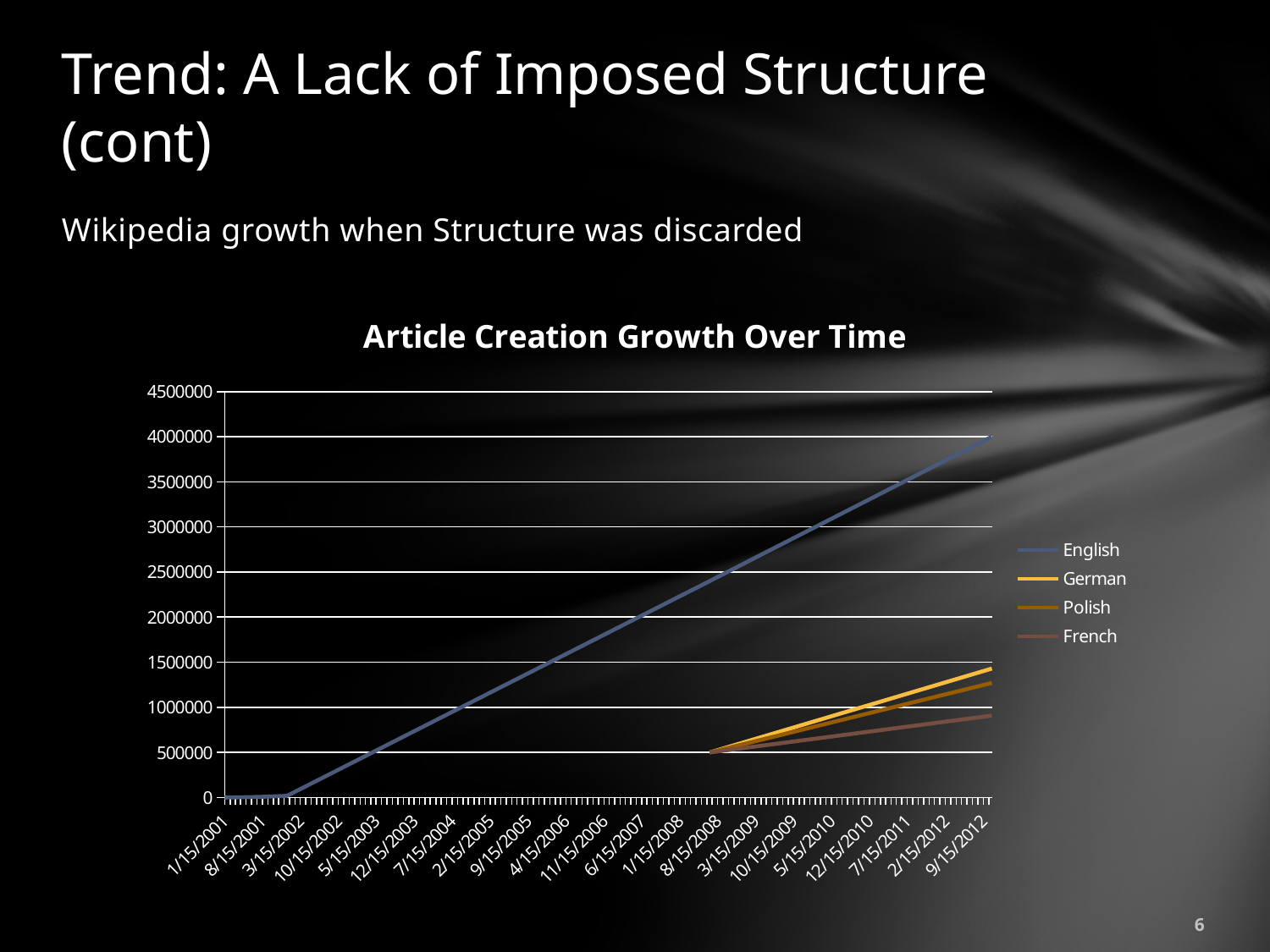
Is the value for English at 1/15/2001 greater or less than 500000? less How many series does the legend of the chart list? 4 Which series has the highest value at 9/15/2012? English Does the English series rise or fall over time along the x axis? Rise At 9/15/2012, which is larger, the German value or the Polish value? German Is the value for French at 9/15/2012 greater or less than 1000000? less What is the title of the chart? Article Creation Growth Over Time Which series is listed first in the legend? English What kind of chart is shown on the slide? Line chart Which series has the lowest value at 9/15/2012? French Is the value for German at 9/15/2012 greater or less than 1000000? greater